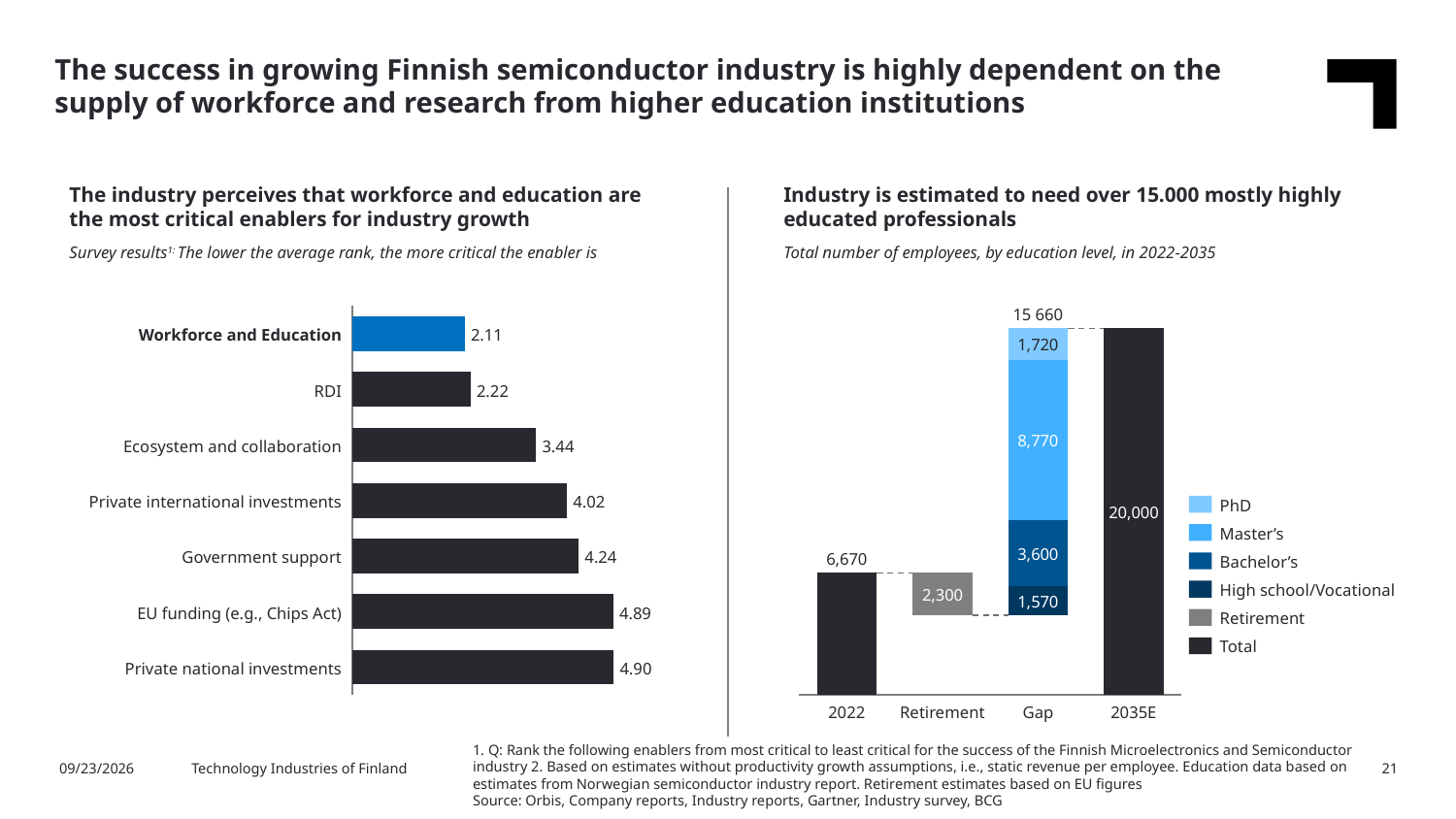
In the right chart (total number of employees), what is the total of the Gap stacked bar? 15 660 How many entries does the legend of the right chart (total number of employees) list? 6 In the left chart (survey results), which enabler has the lowest average rank? Workforce and Education In the left chart (survey results), what is the average rank for Government support? 4.24 In the left chart (survey results), which has the larger average rank, Ecosystem and collaboration or EU funding (e.g., Chips Act)? EU funding (e.g., Chips Act) In the left chart (survey results), what is the difference between the average ranks of Private national investments and RDI? 2.68 How many enablers are listed in the left chart (survey results)? 7 In the right chart (total number of employees), what is the difference between the 2035E total and the 2022 total? 13,330 What kind of chart is the left chart (survey results)? Bar chart In the left chart (survey results), what is the average rank for Workforce and Education? 2.11 In the right chart (total number of employees), how many Master's employees are in the Gap bar? 8,770 In the right chart (total number of employees), what is the total number of employees in 2022? 6,670